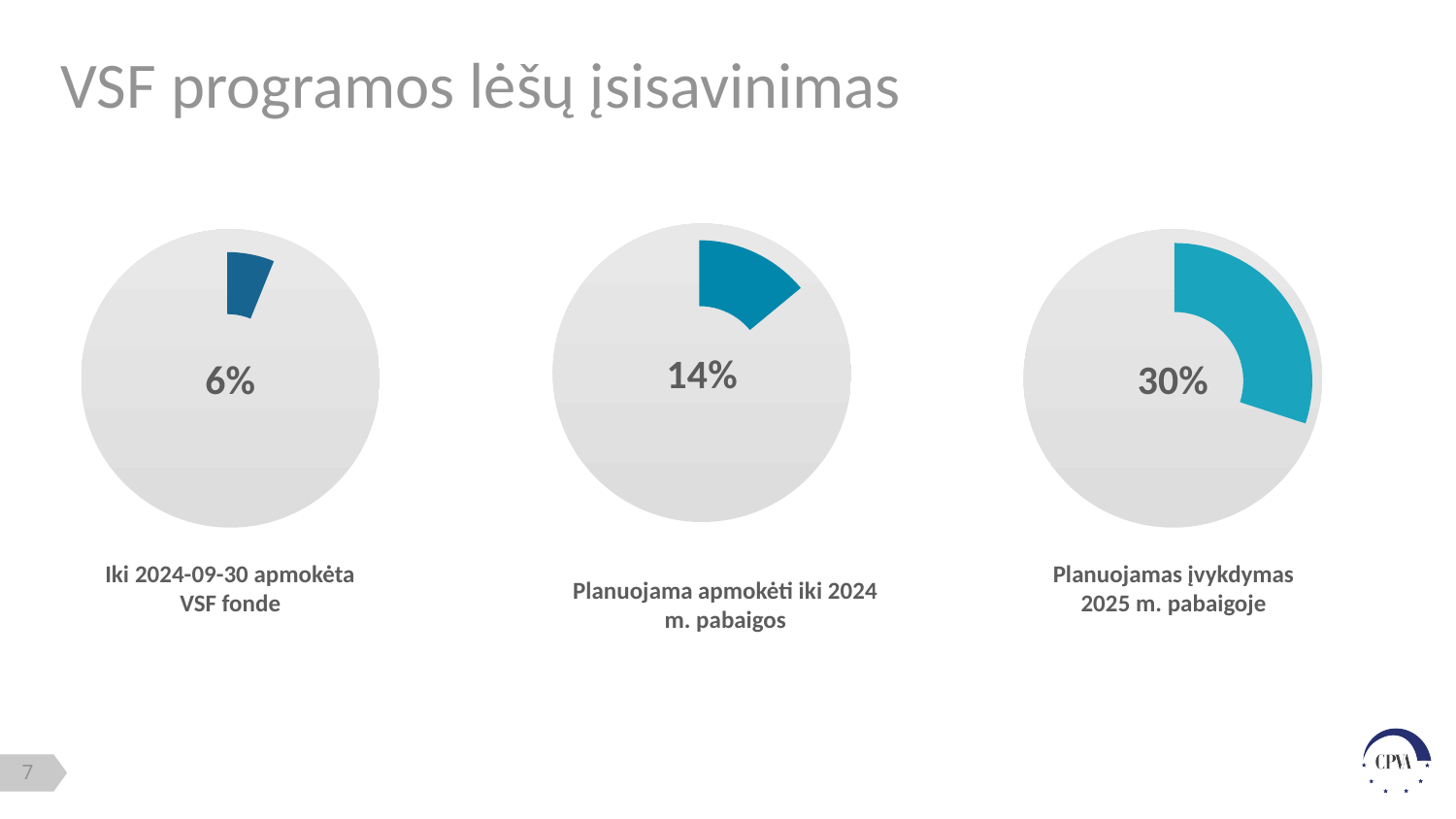
How many charts are shown on the slide? 3 What percentage is shown in the left chart labelled "Iki 2024-09-30 apmokėta VSF fonde"? 6% What percentage is shown in the middle chart labelled "Planuojama apmokėti iki 2024 m. pabaigos"? 14% What kind of chart is used for each of the three figures on the slide? Doughnut chart Do the percentages increase or decrease from the left chart to the right chart? Increase What is the difference between the percentage in the middle chart (Planuojama apmokėti iki 2024 m. pabaigos) and the left chart (Iki 2024-09-30 apmokėta VSF fonde)? 8% Which of the three charts shows the highest percentage? Planuojamas įvykdymas 2025 m. pabaigoje Which of the three charts shows the lowest percentage? Iki 2024-09-30 apmokėta VSF fonde What is the title of the slide containing the three charts? VSF programos lėšų įsisavinimas Which is larger: the percentage in the middle chart (Planuojama apmokėti iki 2024 m. pabaigos) or the right chart (Planuojamas įvykdymas 2025 m. pabaigoje)? Planuojamas įvykdymas 2025 m. pabaigoje What is the difference between the percentage in the right chart (Planuojamas įvykdymas 2025 m. pabaigoje) and the left chart (Iki 2024-09-30 apmokėta VSF fonde)? 24% What percentage is shown in the right chart labelled "Planuojamas įvykdymas 2025 m. pabaigoje"? 30%